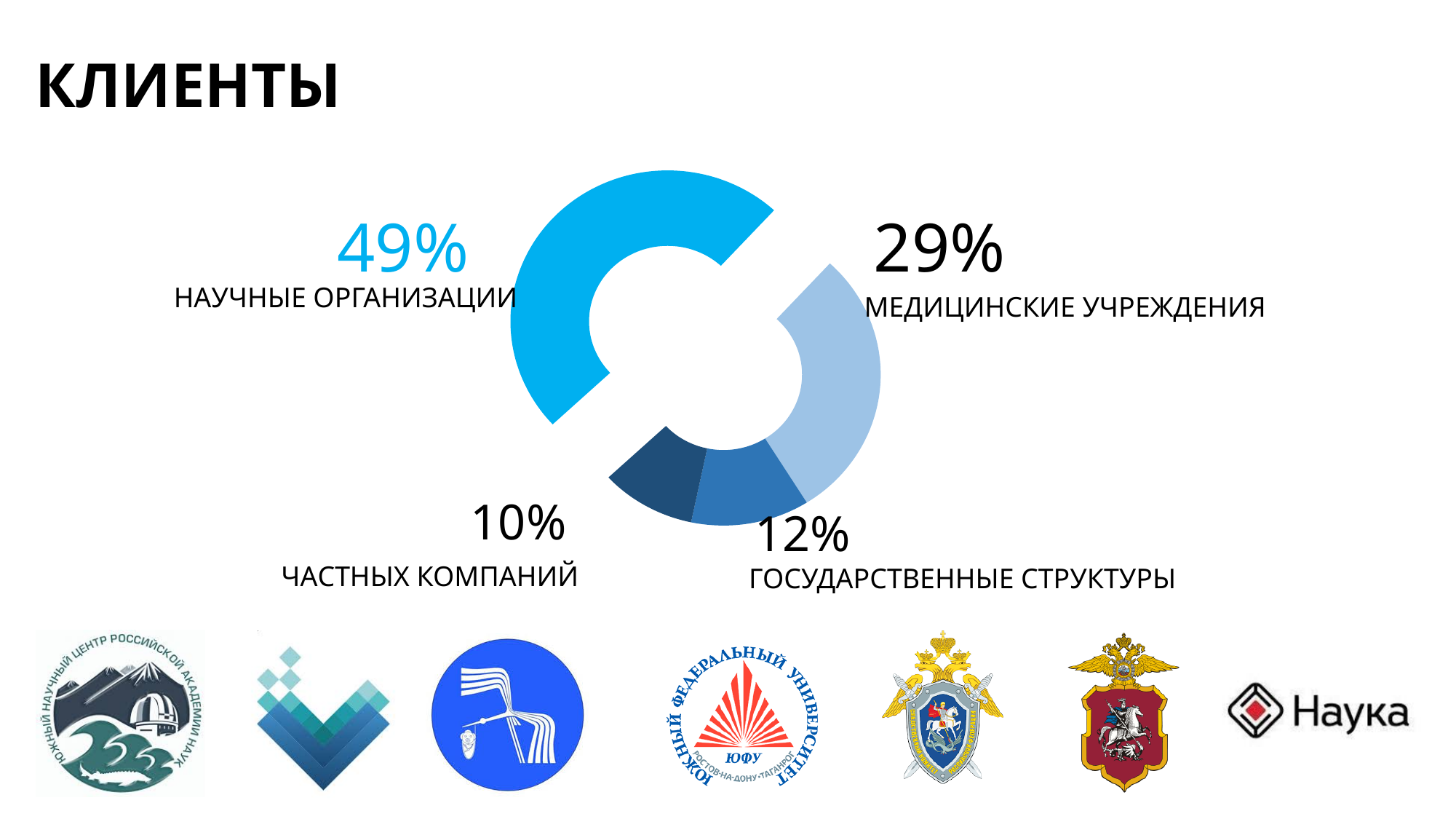
Which client category has the smallest share? Частных компаний What share of clients are медицинские учреждения? 29% What kind of chart is shown on the slide? Doughnut (pie) chart How many client categories are shown in the chart? 4 What is the title of the slide? КЛИЕНТЫ Which is larger: the share of государственные структуры or the share of частных компаний? Государственные структуры What share of clients are государственные структуры? 12% Which client category has the largest share? Научные организации What share of clients are научные организации? 49% What is the difference in percentage points between научные организации and медицинские учреждения? 20 What share of clients are частные компании? 10% What is the combined share of медицинские учреждения and государственные структуры? 41%